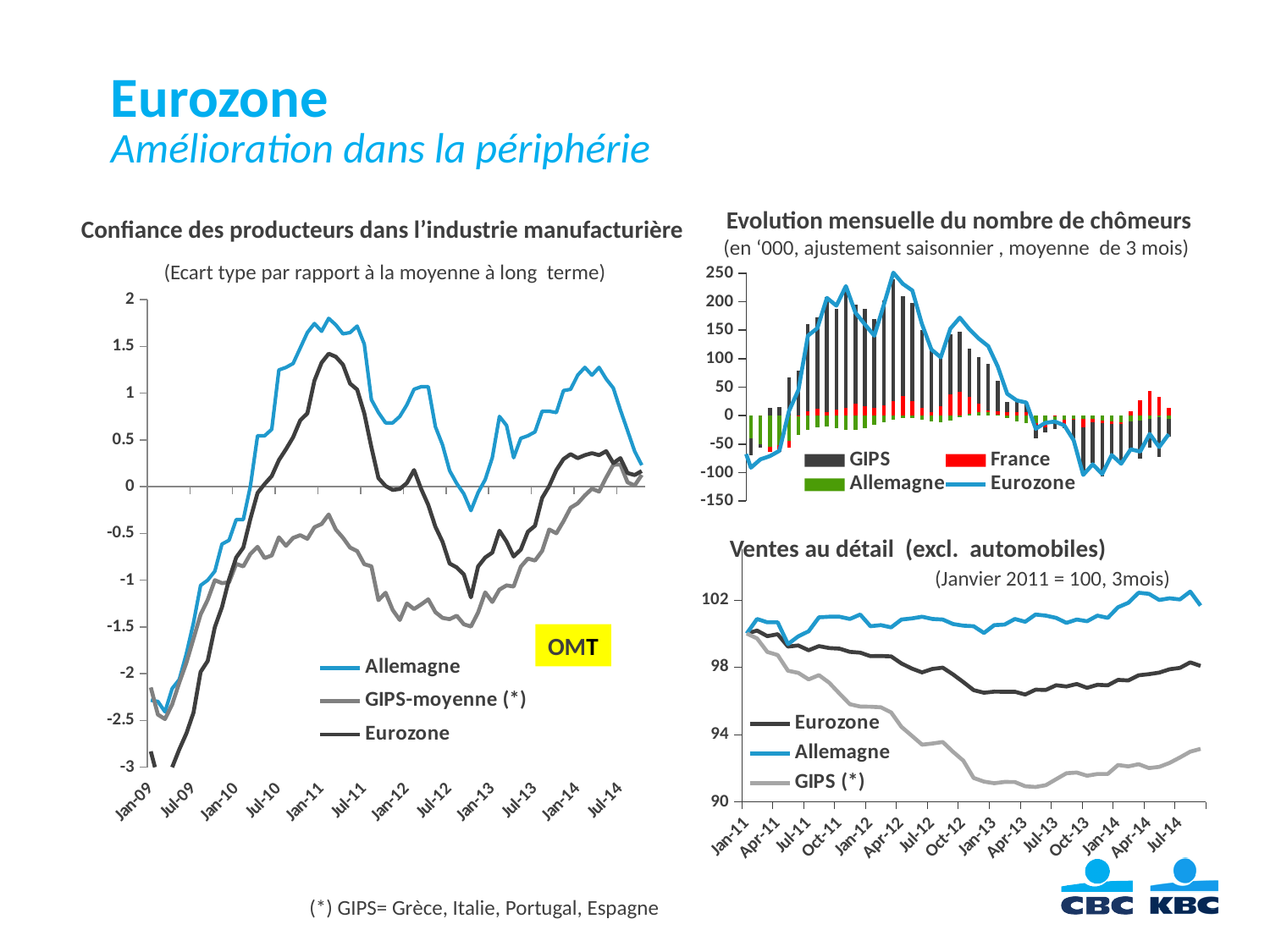
In the chart 'Ventes au détail (excl. automobiles)', how many series does the legend list? 3 In the chart 'Confiance des producteurs dans l'industrie manufacturière', is the value for Allemagne at Jan-11 greater or less than 1.5? greater In the chart 'Ventes au détail (excl. automobiles)', which series is lowest at Jan-13? GIPS (*) What kind of chart is 'Confiance des producteurs dans l'industrie manufacturière'? line chart In the chart 'Ventes au détail (excl. automobiles)', is the value for GIPS (*) at Jan-13 greater or less than 94? less In the chart 'Confiance des producteurs dans l'industrie manufacturière', how many series does the legend list? 3 In the chart 'Confiance des producteurs dans l'industrie manufacturière', which series is highest at Jan-14? Allemagne In the chart 'Confiance des producteurs dans l'industrie manufacturière', is the value for GIPS-moyenne (*) at Jan-09 greater or less than -2? less In the chart 'Evolution mensuelle du nombre de chômeurs', how many series does the legend list? 4 In the chart 'Confiance des producteurs dans l'industrie manufacturière', does the Eurozone series rise or fall between Jan-09 and Jan-11? rise In the chart 'Ventes au détail (excl. automobiles)', does the GIPS (*) series rise or fall between Jan-11 and Jan-13? fall